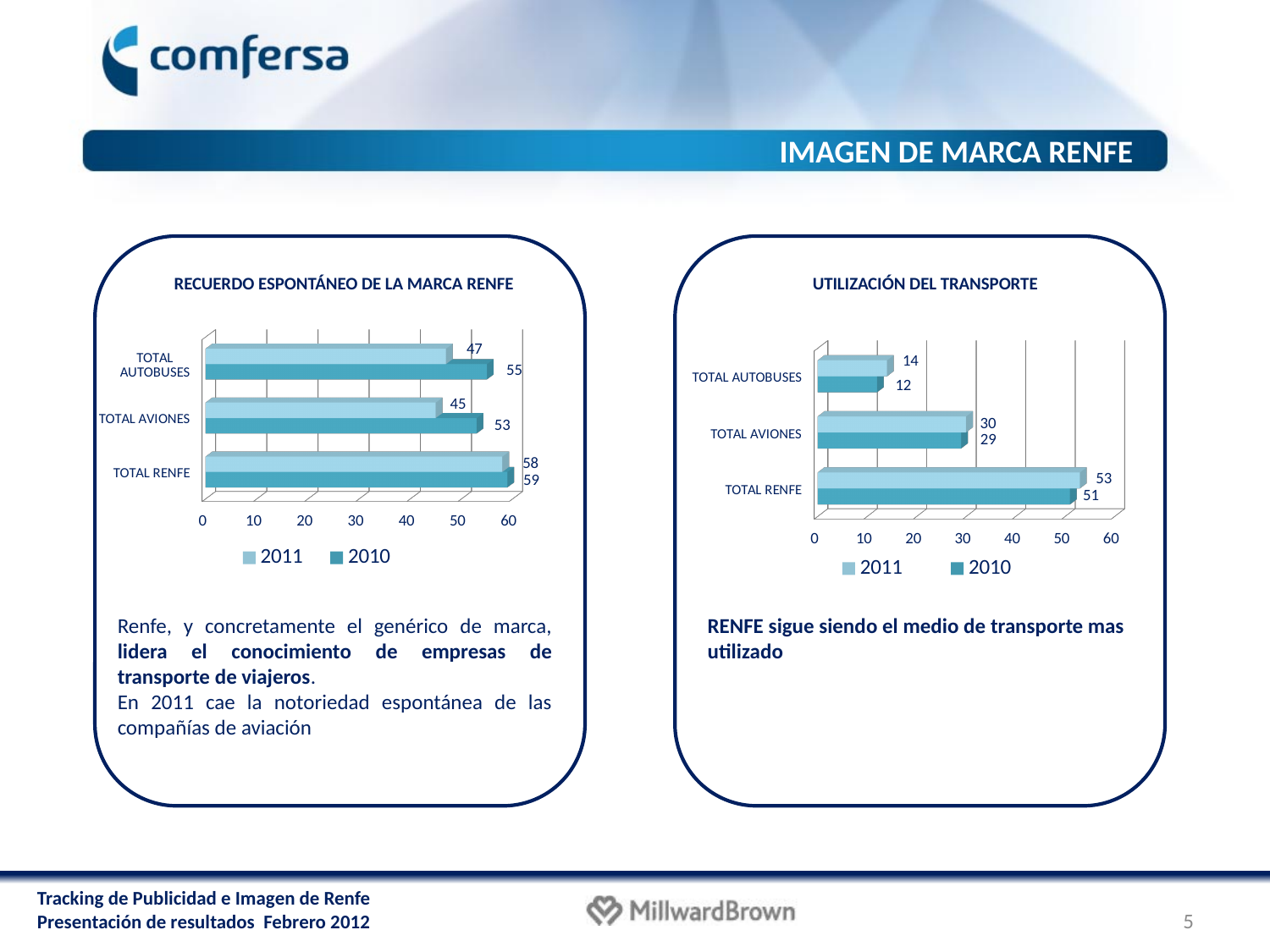
In the 'UTILIZACIÓN DEL TRANSPORTE' chart, which category has the lowest 2011 value? TOTAL AUTOBUSES In the 'RECUERDO ESPONTÁNEO DE LA MARCA RENFE' chart, which category has the highest 2011 value? TOTAL RENFE In the 'RECUERDO ESPONTÁNEO DE LA MARCA RENFE' chart, what is the difference between the 2010 and 2011 values for TOTAL AVIONES? 8 In the 'UTILIZACIÓN DEL TRANSPORTE' chart, what is the 2011 value for TOTAL RENFE? 53 What type of chart is the 'UTILIZACIÓN DEL TRANSPORTE' chart? Bar chart In the 'RECUERDO ESPONTÁNEO DE LA MARCA RENFE' chart, how many series does the legend list? 2 In the 'RECUERDO ESPONTÁNEO DE LA MARCA RENFE' chart, what is the 2011 value for TOTAL AUTOBUSES? 47 In the 'UTILIZACIÓN DEL TRANSPORTE' chart, how many categories are shown? 3 In the 'UTILIZACIÓN DEL TRANSPORTE' chart, what is the difference between the 2011 values for TOTAL RENFE and TOTAL AVIONES? 23 In the 'RECUERDO ESPONTÁNEO DE LA MARCA RENFE' chart, what is the 2010 value for TOTAL AVIONES? 53 In the 'UTILIZACIÓN DEL TRANSPORTE' chart, what is the 2010 value for TOTAL AUTOBUSES? 12 In the 'UTILIZACIÓN DEL TRANSPORTE' chart, is the 2011 value for TOTAL AVIONES larger or smaller than the 2010 value? larger